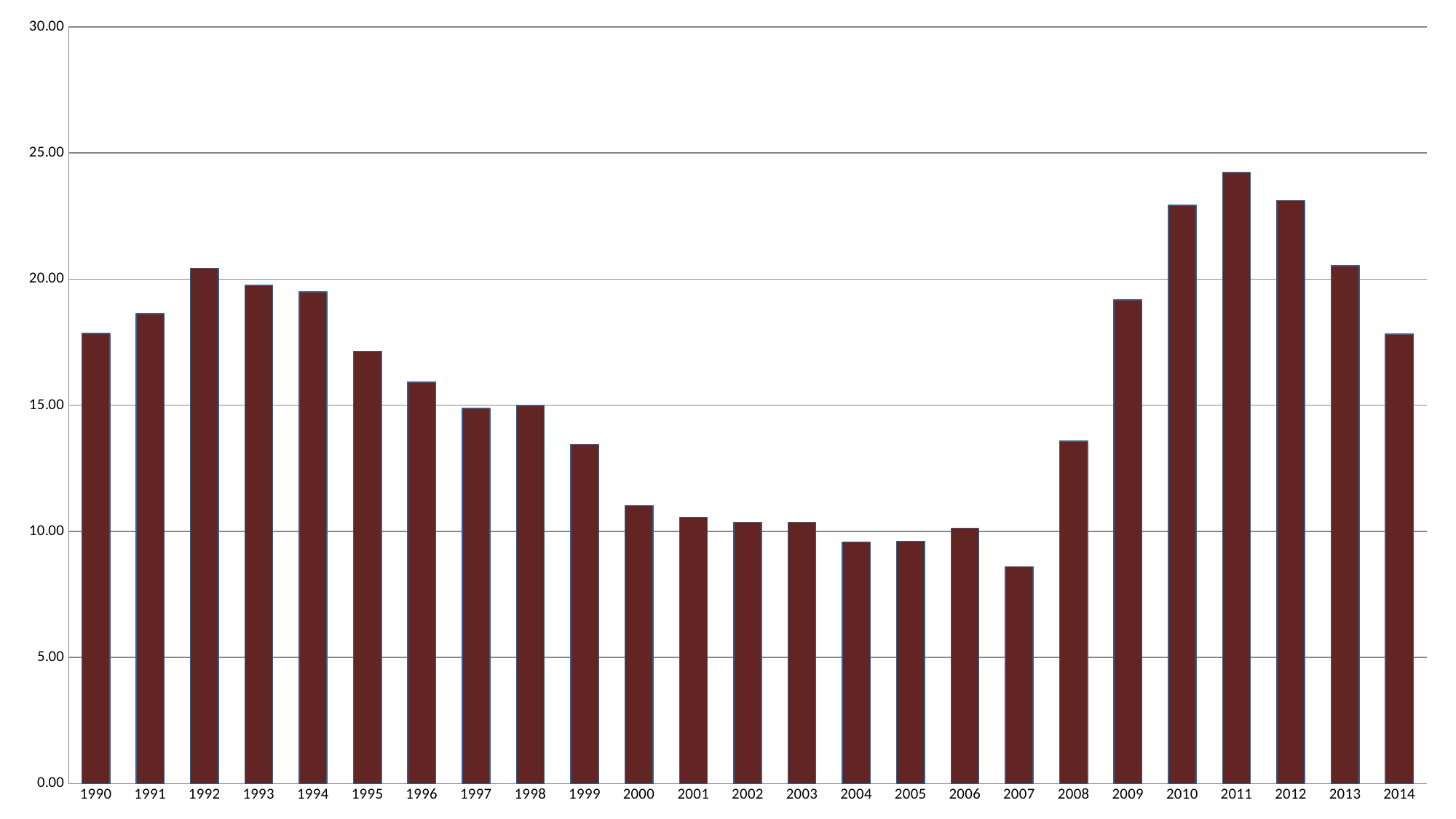
Which year has the highest bar in the chart? 2011 Is the value for 1999 greater or less than 15.00? less Which year has the lowest bar in the chart? 2007 Is the value for 2010 greater or less than 20.00? greater How many years are shown on the x axis of the chart? 25 Which year has the larger value, 2008 or 2009? 2009 Is the value for 1990 greater or less than 15.00? greater Do the values generally rise or fall from 1992 to 2007? fall What kind of chart is shown on the slide? bar chart Which year has the larger value, 1990 or 1992? 1992